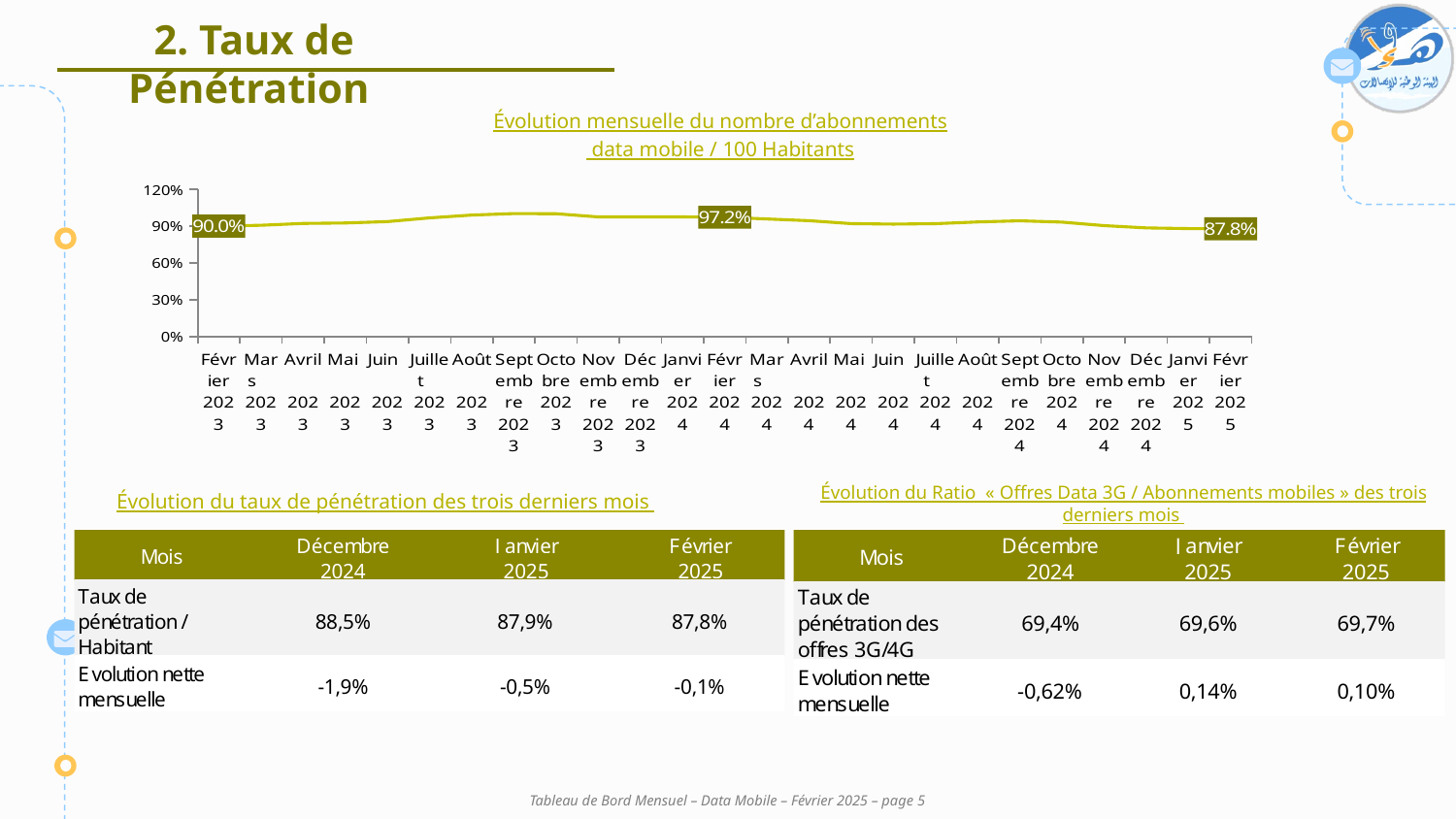
Is the value for Juin 2024 on the line chart greater or less than 60%? greater Of the three labelled points on the line chart, which month has the lowest value? Février 2025 What is the difference between the labelled values for Février 2024 and Février 2025 on the line chart? 9.4 percentage points What kind of chart is used to show the monthly evolution of data mobile subscriptions per 100 inhabitants? line chart What is the value shown for Février 2024 on the line chart? 97.2% What is the title of the line chart? Évolution mensuelle du nombre d'abonnements data mobile / 100 Habitants What is the value shown for Février 2025 on the line chart? 87.8% What is the difference between the labelled values for Février 2024 and Février 2023 on the line chart? 7.2 percentage points What is the value shown for Février 2023 on the line chart? 90.0% How many monthly points are plotted on the line chart? 25 Of the three labelled points on the line chart, which month has the highest value? Février 2024 Which is larger on the line chart: the value for Février 2023 or the value for Février 2025? Février 2023